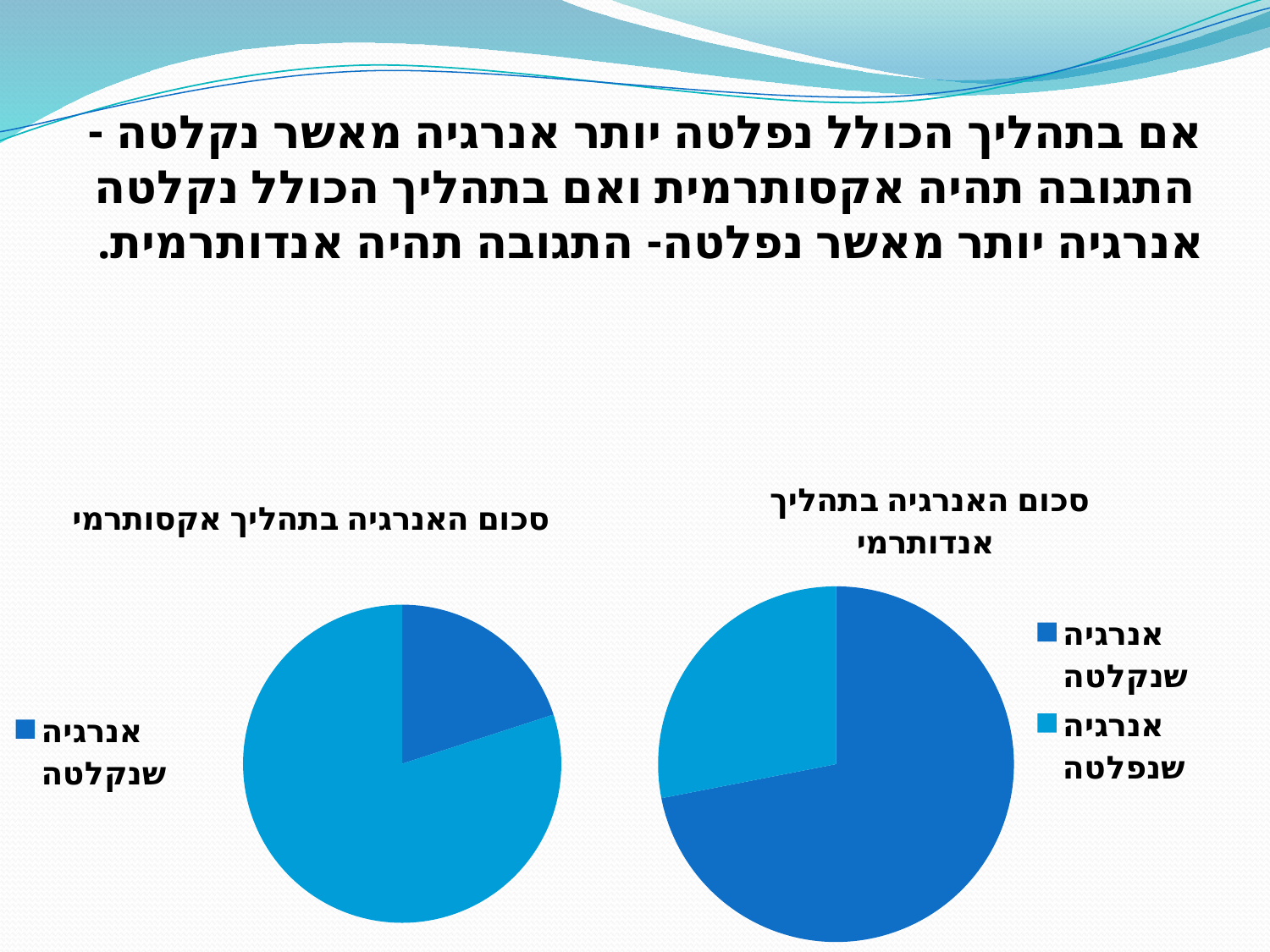
In the chart titled "סכום האנרגיה בתהליך אקסותרמי", is the slice for אנרגיה שנקלטה the larger or the smaller slice? smaller In the chart titled "סכום האנרגיה בתהליך אנדותרמי", which is larger: אנרגיה שנקלטה or אנרגיה שנפלטה? אנרגיה שנקלטה What kind of chart is the chart titled "סכום האנרגיה בתהליך אקסותרמי"? pie chart What is the only legend entry shown for the chart titled "סכום האנרגיה בתהליך אקסותרמי"? אנרגיה שנקלטה How many entries does the legend of the chart titled "סכום האנרגיה בתהליך אקסותרמי" list? 1 How many slices does the pie chart titled "סכום האנרגיה בתהליך אקסותרמי" have? 2 How many entries does the legend of the chart titled "סכום האנרגיה בתהליך אנדותרמי" list? 2 What kind of chart is the chart titled "סכום האנרגיה בתהליך אנדותרמי"? pie chart In the chart titled "סכום האנרגיה בתהליך אנדותרמי", which slice is the smallest? אנרגיה שנפלטה How many slices does the pie chart titled "סכום האנרגיה בתהליך אנדותרמי" have? 2 What is the title of the pie chart on the left side of the slide? סכום האנרגיה בתהליך אקסותרמי In the chart titled "סכום האנרגיה בתהליך אנדותרמי", which slice is the largest? אנרגיה שנקלטה